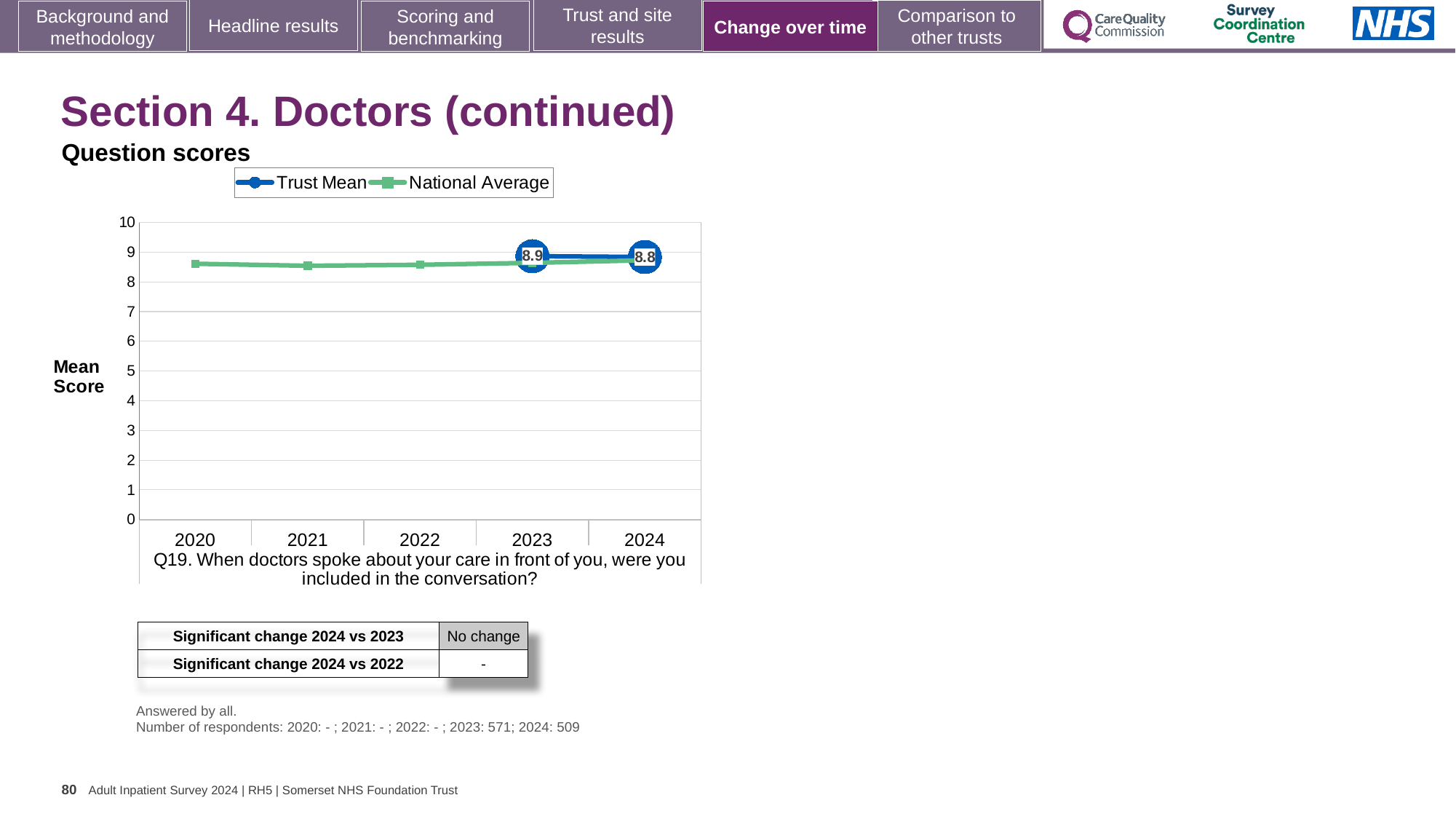
How many series does the legend list? 2 What is the label on the y axis of the chart? Mean Score What kind of chart is shown on the slide? Line chart Is the National Average value for 2021 greater or less than 9? less Does the Trust Mean rise or fall from 2023 to 2024? Fall What are the two series named in the chart legend? Trust Mean and National Average How many years are shown on the x axis of the chart? 5 Which year has the higher Trust Mean score, 2023 or 2024? 2023 Is the National Average value for 2020 greater or less than 8? greater What is the Trust Mean score for 2024? 8.8 What is the Trust Mean score for 2023? 8.9 What is the difference between the Trust Mean scores for 2023 and 2024? 0.1